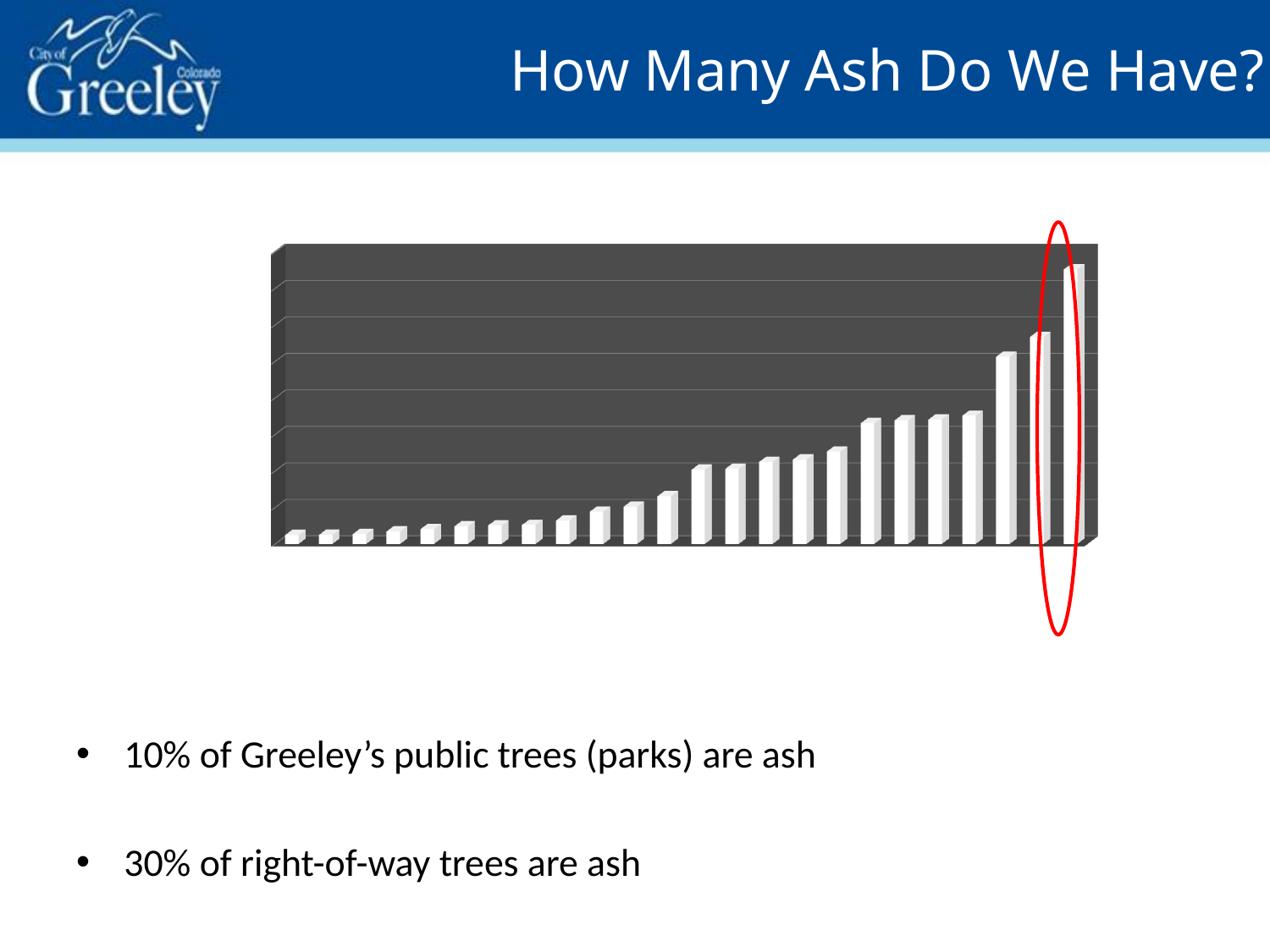
Is the rightmost bar taller or shorter than the leftmost bar? taller What colour are the bars in the chart? white What kind of chart is shown on the slide? bar chart Which bar is highlighted with a red oval on the chart? the rightmost (tallest) bar Which bar in the chart is the shortest? the leftmost bar Which bar in the chart is the tallest? the rightmost bar Do the bar values rise or fall from left to right across the chart? rise